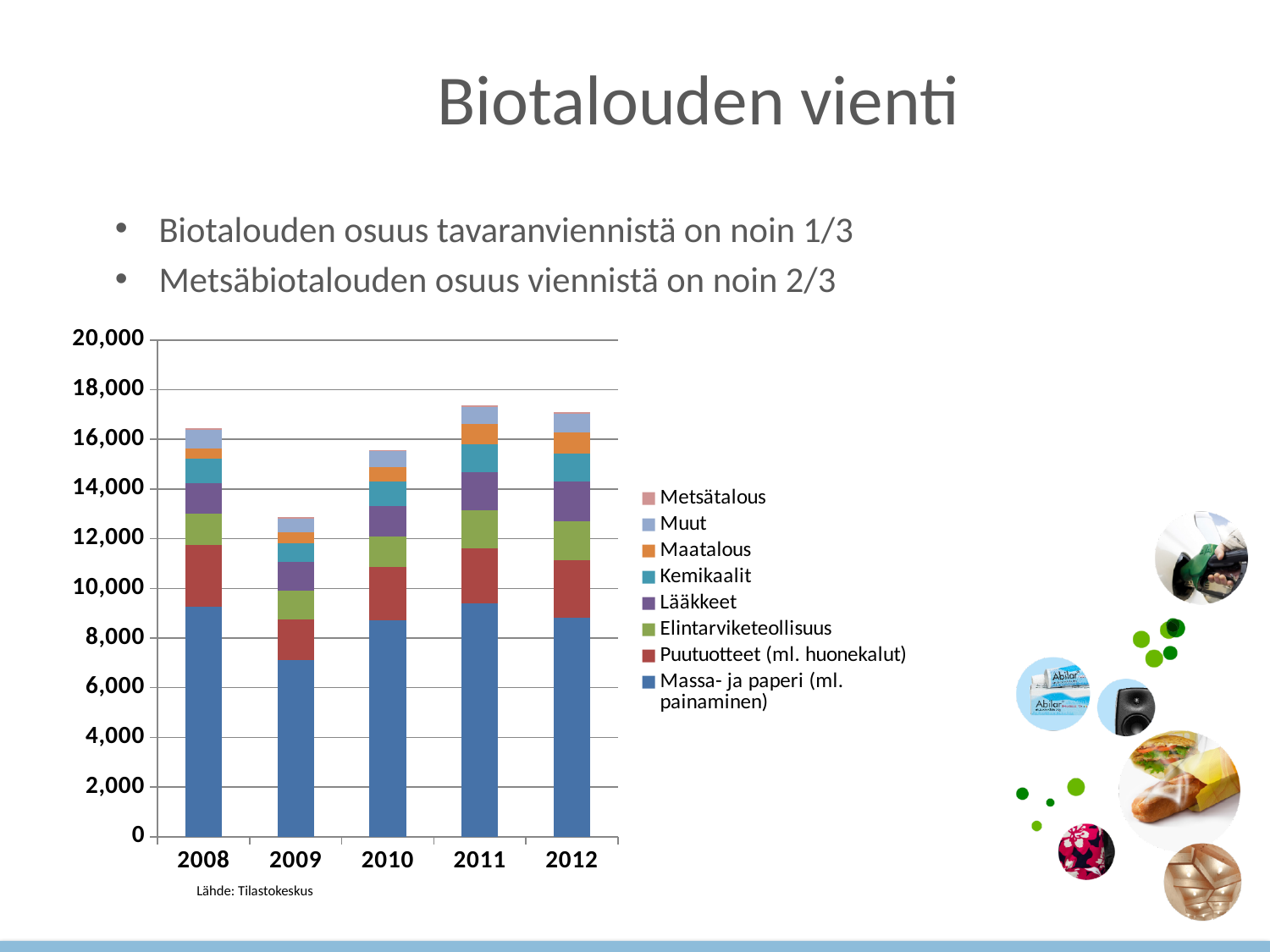
Is the Massa- ja paperi (ml. painaminen) segment for 2009 greater or less than 8,000? less Is the total bar for 2011 greater or less than 16,000? greater Do the total bars rise or fall from 2009 to 2011? rise Is the total bar for 2009 greater or less than 14,000? less Which year has the larger total bar, 2008 or 2009? 2008 What kind of chart is shown on the slide? stacked bar chart Which year has the lowest total bar in the chart? 2009 How many years are shown on the x axis of the chart? 5 What source is cited below the chart? Tilastokeskus Which series forms the bottom (blue) segment of each stacked bar? Massa- ja paperi (ml. painaminen) How many series does the chart's legend list? 8